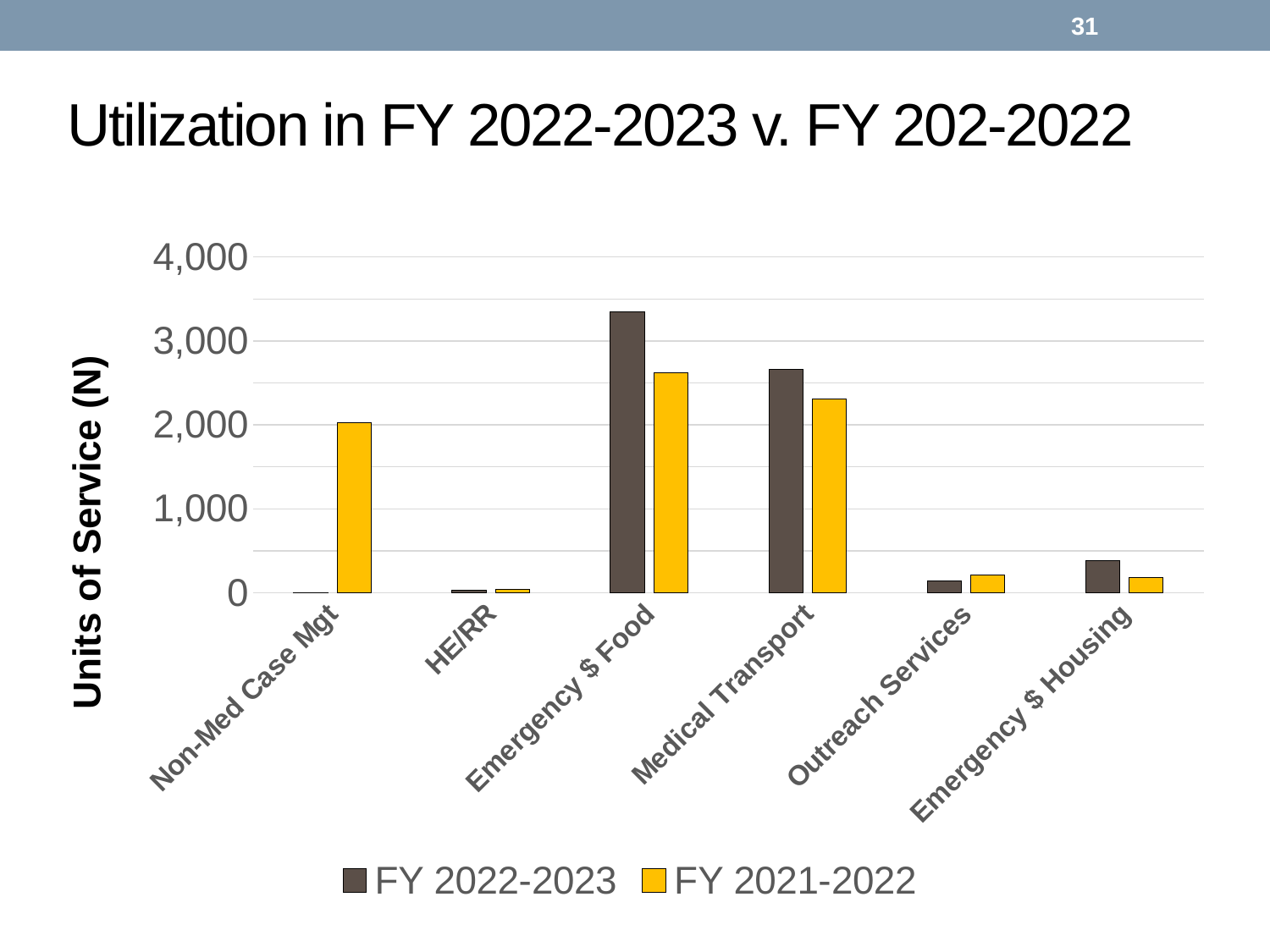
How many series does the legend list? 2 What kind of chart is shown on the slide? bar chart For Emergency $ Housing, which series has the larger value, FY 2022-2023 or FY 2021-2022? FY 2022-2023 Is the FY 2022-2023 value for Emergency $ Food greater or less than 3,000? greater Is the FY 2022-2023 value for Emergency $ Housing greater or less than 1,000? less Which category has the highest FY 2021-2022 value? Emergency $ Food What is the label on the y axis? Units of Service (N) Is the FY 2021-2022 value for Non-Med Case Mgt greater or less than 1,000? greater For Non-Med Case Mgt, which series has the larger value, FY 2022-2023 or FY 2021-2022? FY 2021-2022 How many service categories are shown on the x axis? 6 Which category has the highest FY 2022-2023 value? Emergency $ Food